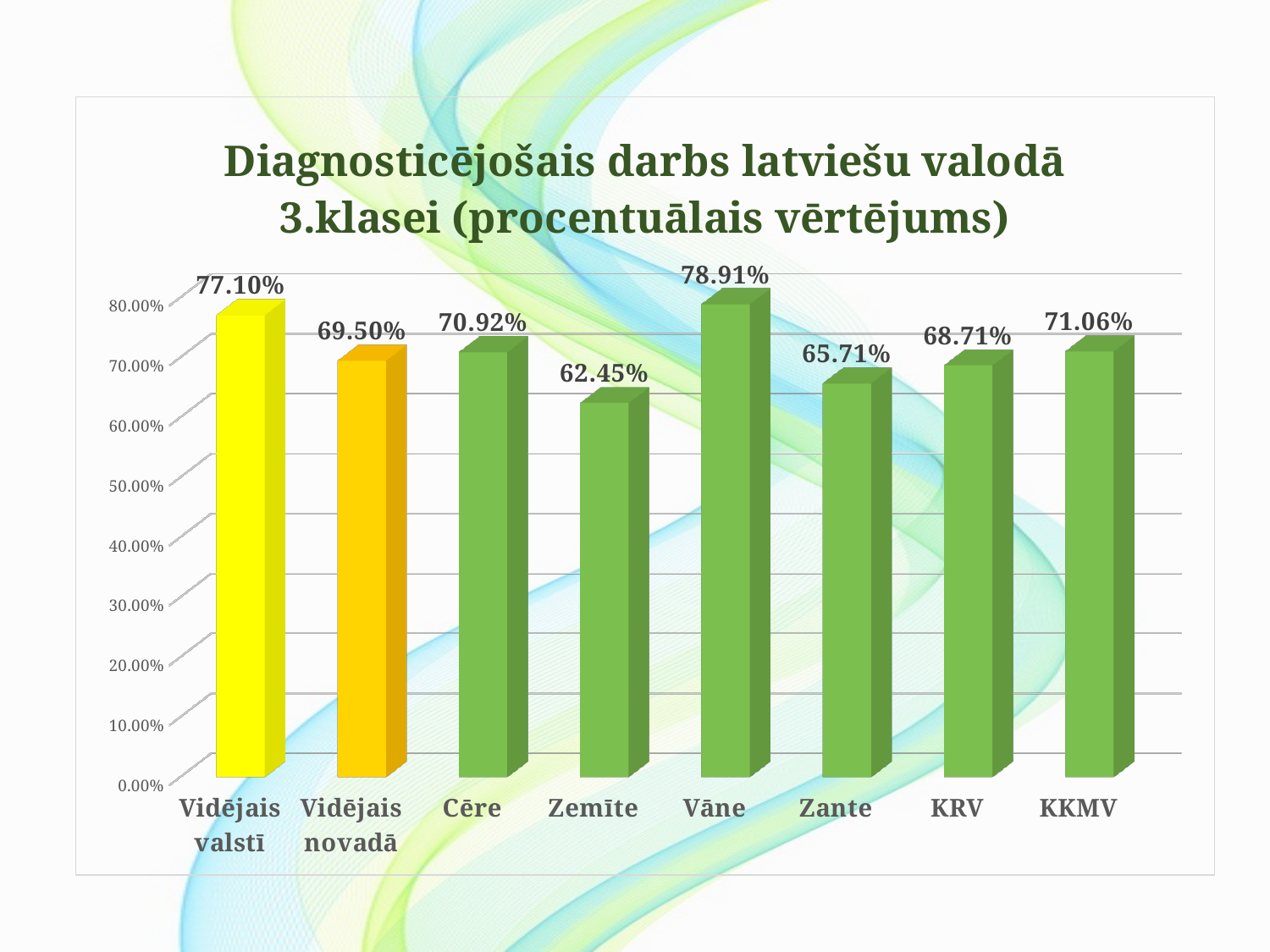
What is the value for Vāne? 78.91% Which category has the lowest value? Zemīte Which is larger, the value for Cēre or the value for KRV? Cēre What is the title of the chart? Diagnosticējošais darbs latviešu valodā 3.klasei (procentuālais vērtējums) What is the value for Zemīte? 62.45% How many categories are shown on the x axis? 8 What is the difference between the values for Vāne and Zemīte? 16.46% What kind of chart is this? Bar chart What is the value for Vidējais novadā? 69.50% What is the value for KKMV? 71.06% What is the difference between the values for Vidējais valstī and Vidējais novadā? 7.60% Which category has the highest value? Vāne